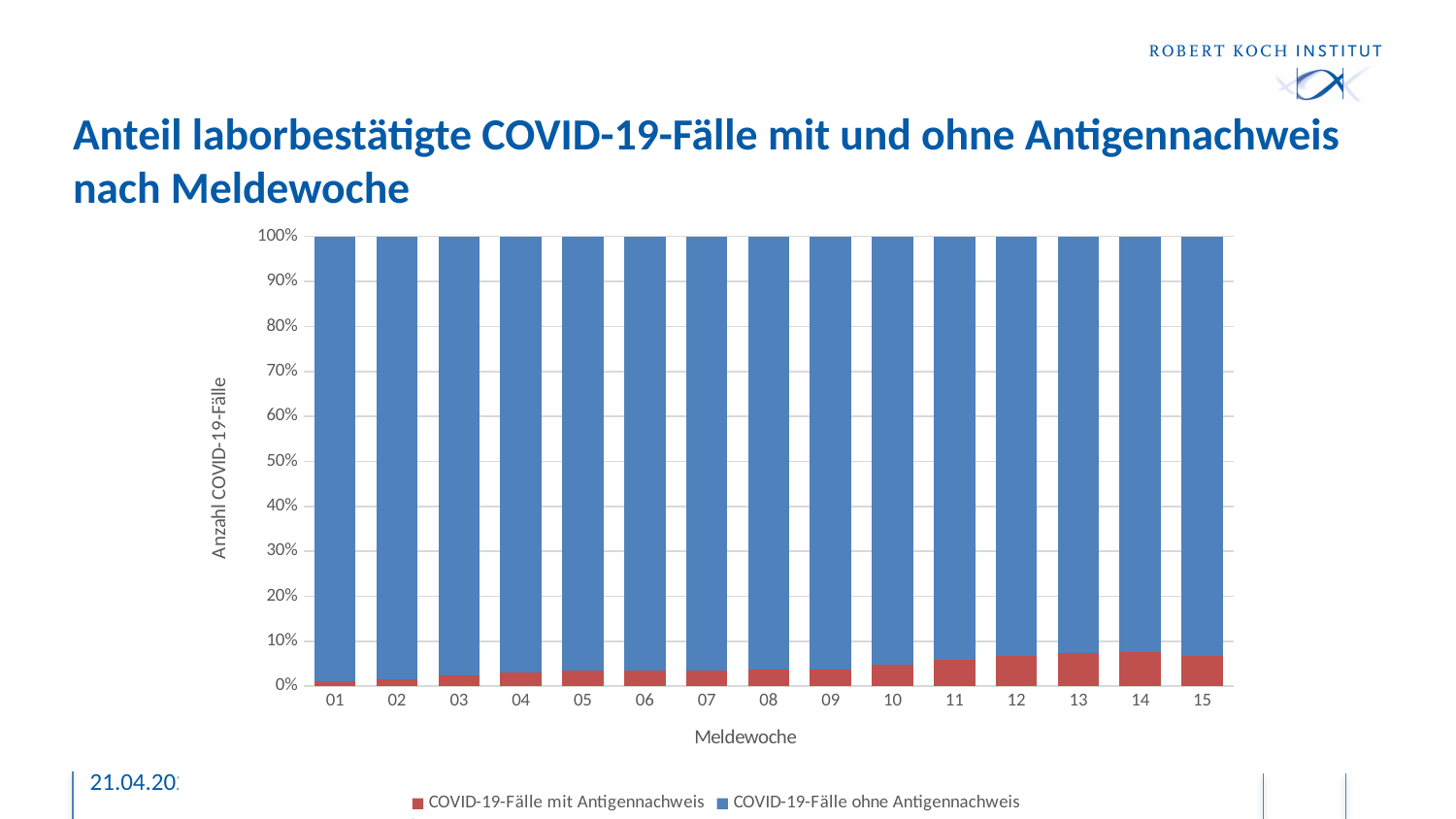
In which Meldewoche is the share of COVID-19-Fälle mit Antigennachweis lowest? 01 What is the title of the chart? Anteil laborbestätigte COVID-19-Fälle mit und ohne Antigennachweis nach Meldewoche What is the total height of each stacked bar? 100% How many Meldewochen (reporting weeks) are shown on the x axis? 15 Is the share of COVID-19-Fälle ohne Antigennachweis in Meldewoche 01 greater or less than 90%? greater Which is larger: the share of COVID-19-Fälle mit Antigennachweis in Meldewoche 01 or in Meldewoche 14? Meldewoche 14 Is the share of COVID-19-Fälle mit Antigennachweis in Meldewoche 05 greater or less than 10%? less Does the share of COVID-19-Fälle mit Antigennachweis generally rise or fall from Meldewoche 01 to Meldewoche 14? rise Which series is shown in red? COVID-19-Fälle mit Antigennachweis How many series does the legend list? 2 Is the share of COVID-19-Fälle mit Antigennachweis in Meldewoche 14 greater or less than 10%? less What kind of chart is shown on the slide? bar chart